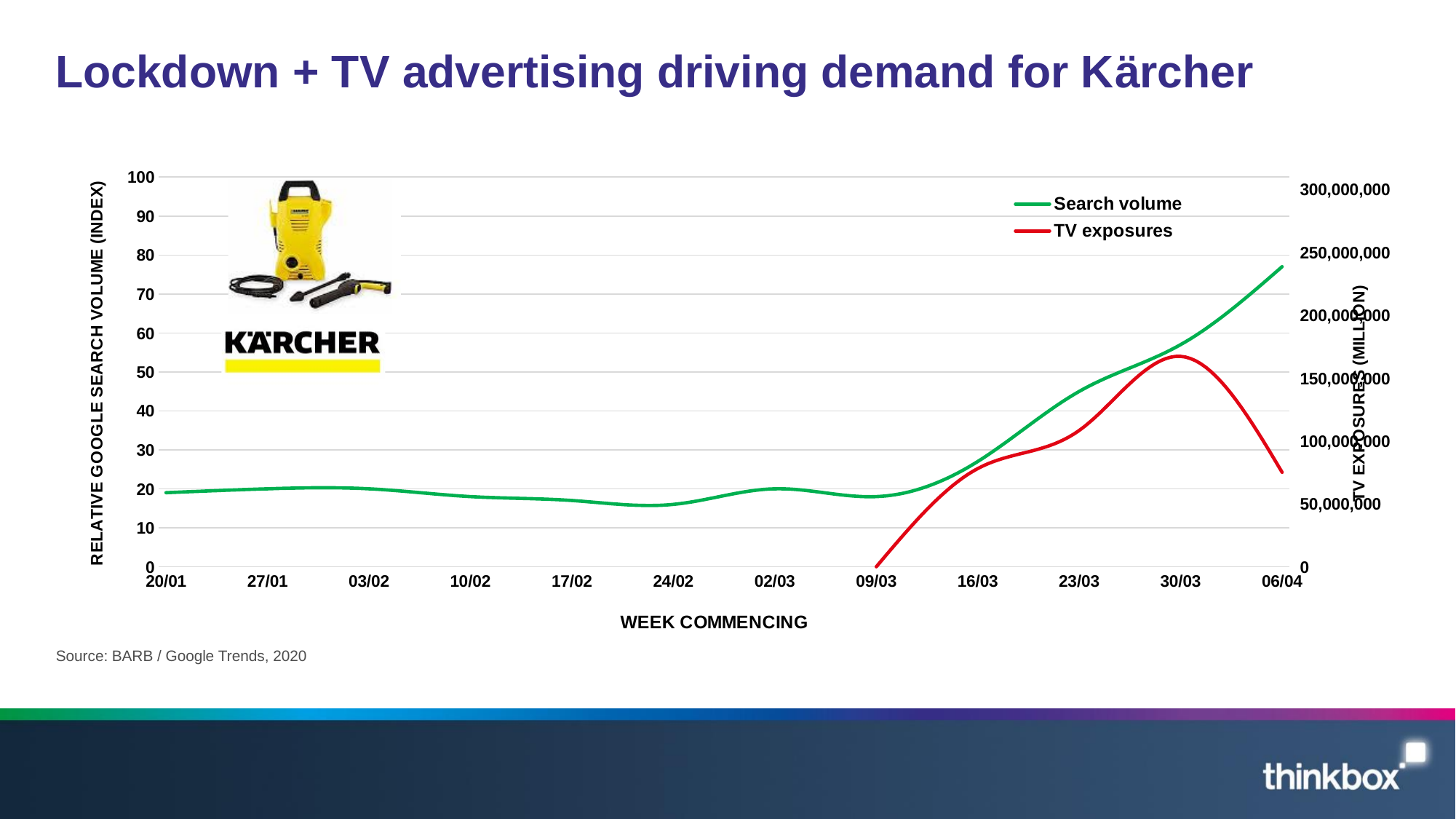
Which week has the highest TV exposures? 30/03 How many series does the legend list? 2 Is the Search volume for 24/02 greater or less than 20? less What kind of chart is shown on the slide? line chart Is the TV exposures value for 30/03 greater or less than 150,000,000? greater How many weeks are labelled along the x axis? 12 Which week has the highest Search volume? 06/04 Is the TV exposures value for 06/04 greater or less than 100,000,000? less What is the title of the x axis? WEEK COMMENCING Does the TV exposures line rise or fall between 30/03 and 06/04? fall Does the Search volume rise or fall between 09/03 and 06/04? rise